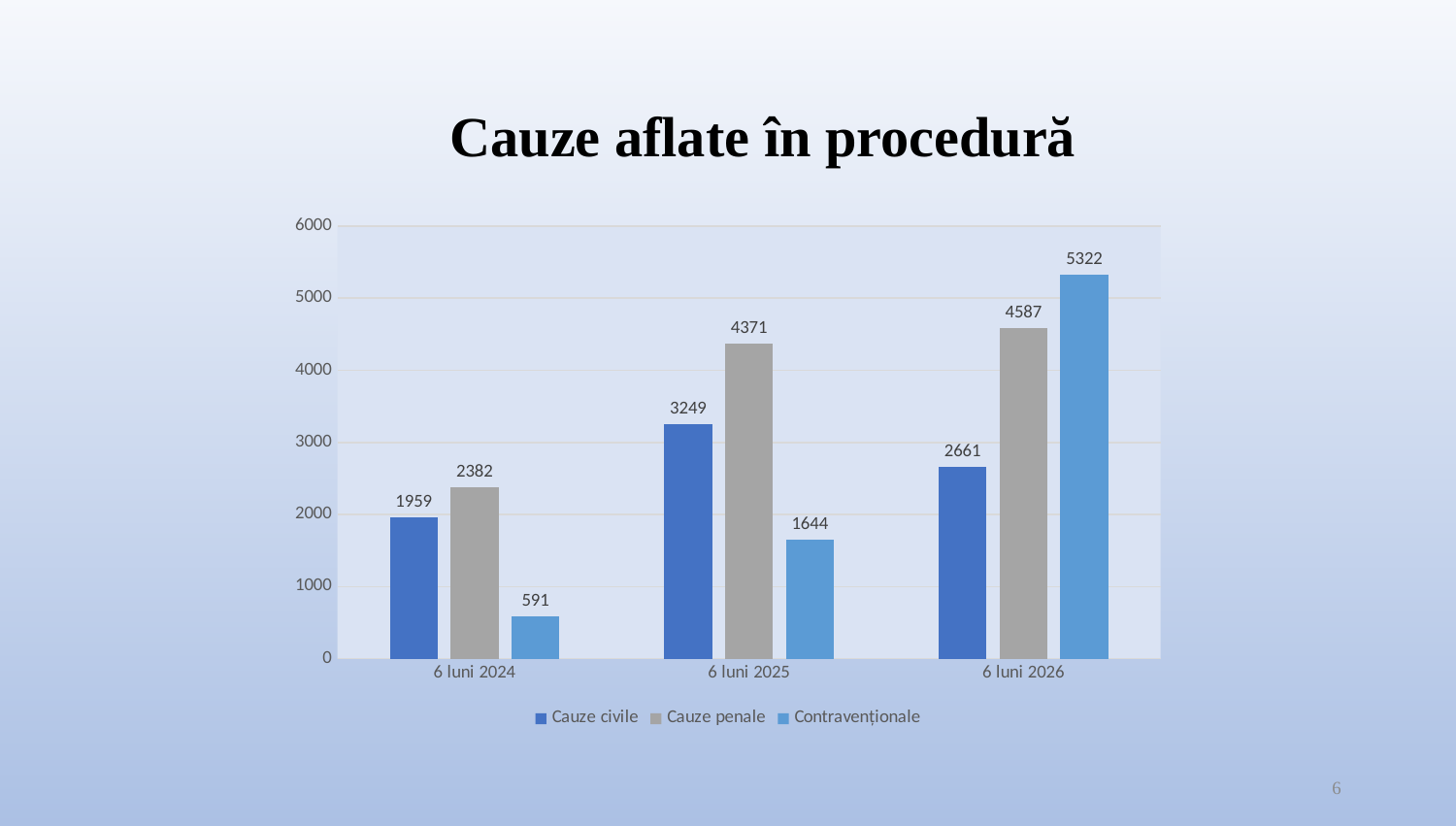
What kind of chart is shown on the slide? bar chart Which is larger in 6 luni 2026: Cauze civile or Contravenționale? Contravenționale How many series does the legend list? 3 Is the value for Cauze civile in 6 luni 2025 greater or less than 3000? greater What is the value for Cauze penale in 6 luni 2025? 4371 What is the value for Cauze civile in 6 luni 2024? 1959 What is the title of the chart? Cauze aflate în procedură Which period has the lowest value for Contravenționale? 6 luni 2024 What is the value for Contravenționale in 6 luni 2026? 5322 How many periods are shown on the x axis? 3 What is the difference between Cauze penale and Cauze civile in 6 luni 2024? 423 Which period has the highest value for Cauze penale? 6 luni 2026